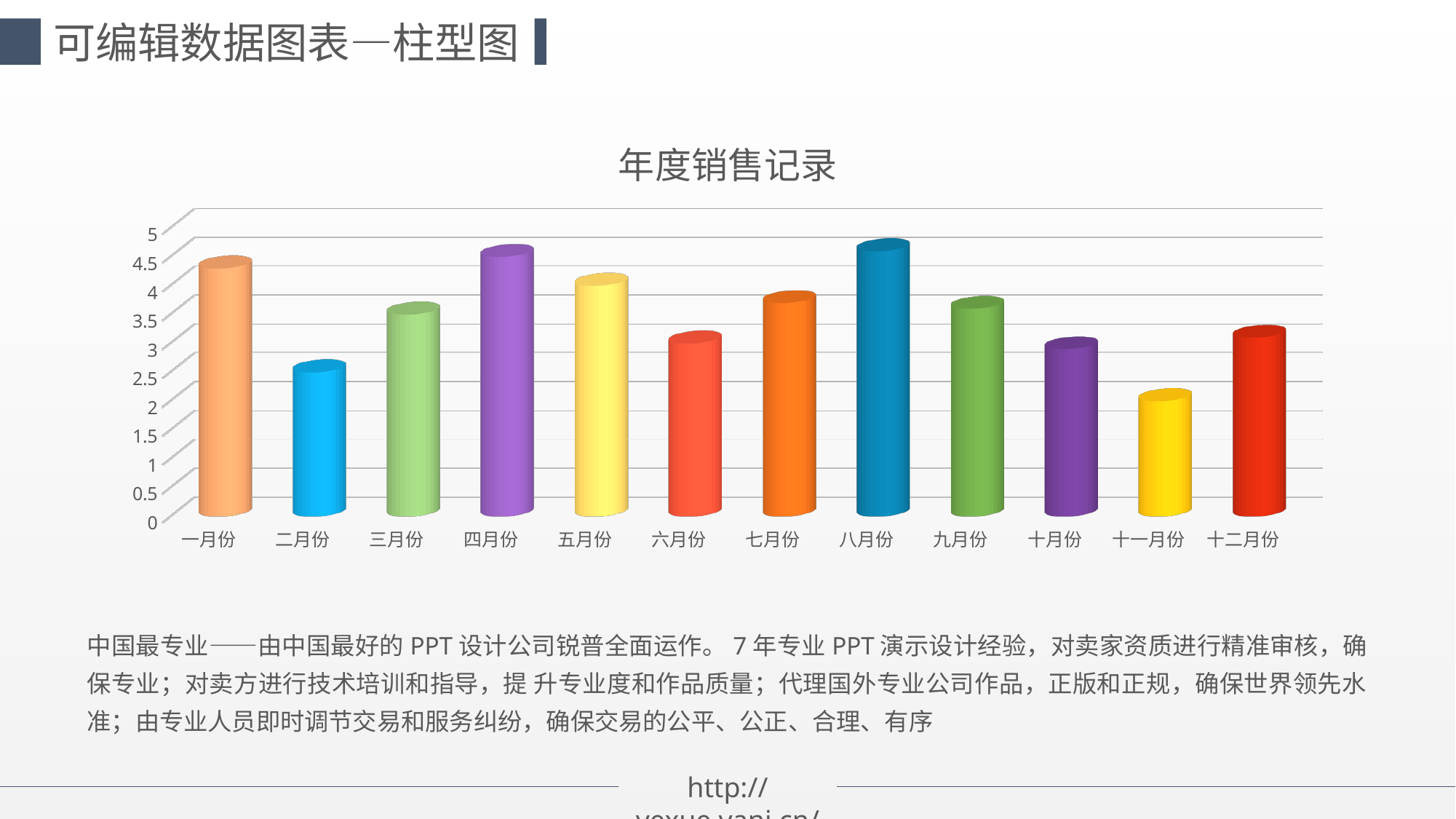
Is the value for 二月份 greater or less than 3? less Is the value for 十一月份 greater or less than 2.5? less Which month has the lowest value? 十一月份 What is the title of the chart? 年度销售记录 How many categories (months) are plotted on the x axis? 12 Is the value for 八月份 greater or less than 4? greater Which is larger, the value for 八月份 or 十二月份? 八月份 Which is larger, the value for 五月份 or 六月份? 五月份 Which is larger, the value for 一月份 or 二月份? 一月份 What kind of chart is shown on the slide? Bar chart